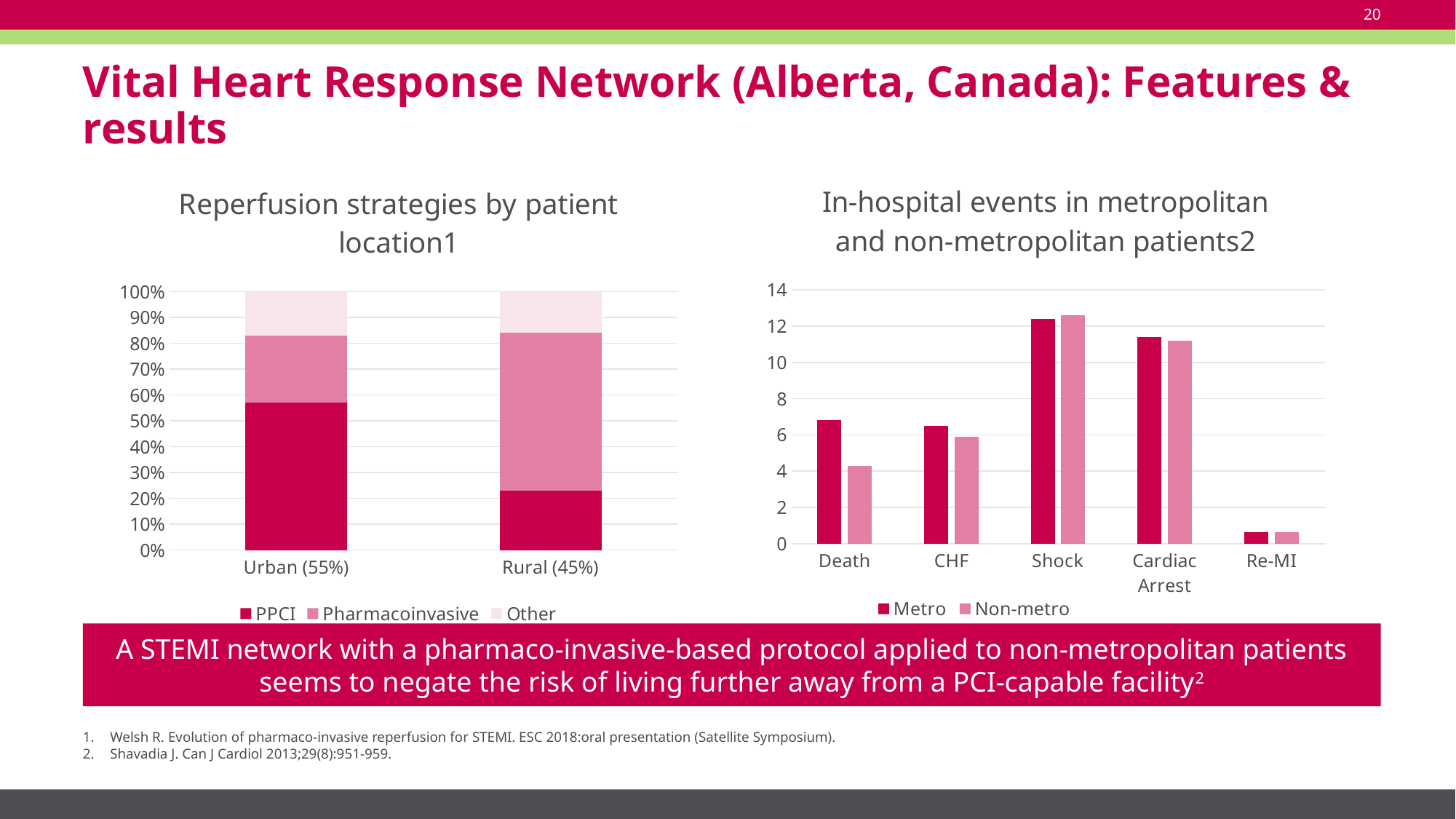
In the 'Reperfusion strategies by patient location' chart, is the PPCI share for Rural (45%) greater or less than 30%? less In the 'Reperfusion strategies by patient location' chart, how many series does the legend list? 3 What kind of chart is the 'Reperfusion strategies by patient location' chart? Stacked bar chart In the 'Reperfusion strategies by patient location' chart, how many patient location categories are shown on the x axis? 2 In the 'In-hospital events in metropolitan and non-metropolitan patients' chart, which event has the lowest Non-metro value? Re-MI In the 'In-hospital events in metropolitan and non-metropolitan patients' chart, is the Death value larger for Metro or Non-metro? Metro In the 'In-hospital events in metropolitan and non-metropolitan patients' chart, how many event categories are shown on the x axis? 5 In the 'In-hospital events in metropolitan and non-metropolitan patients' chart, which event has the highest Metro value? Shock In the 'Reperfusion strategies by patient location' chart, is the PPCI share larger for Urban (55%) or Rural (45%) patients? Urban (55%) What kind of chart is the 'In-hospital events in metropolitan and non-metropolitan patients' chart? Bar chart In the 'Reperfusion strategies by patient location' chart, is the PPCI share for Urban (55%) greater or less than 50%? greater In the 'In-hospital events in metropolitan and non-metropolitan patients' chart, how many series does the legend list? 2